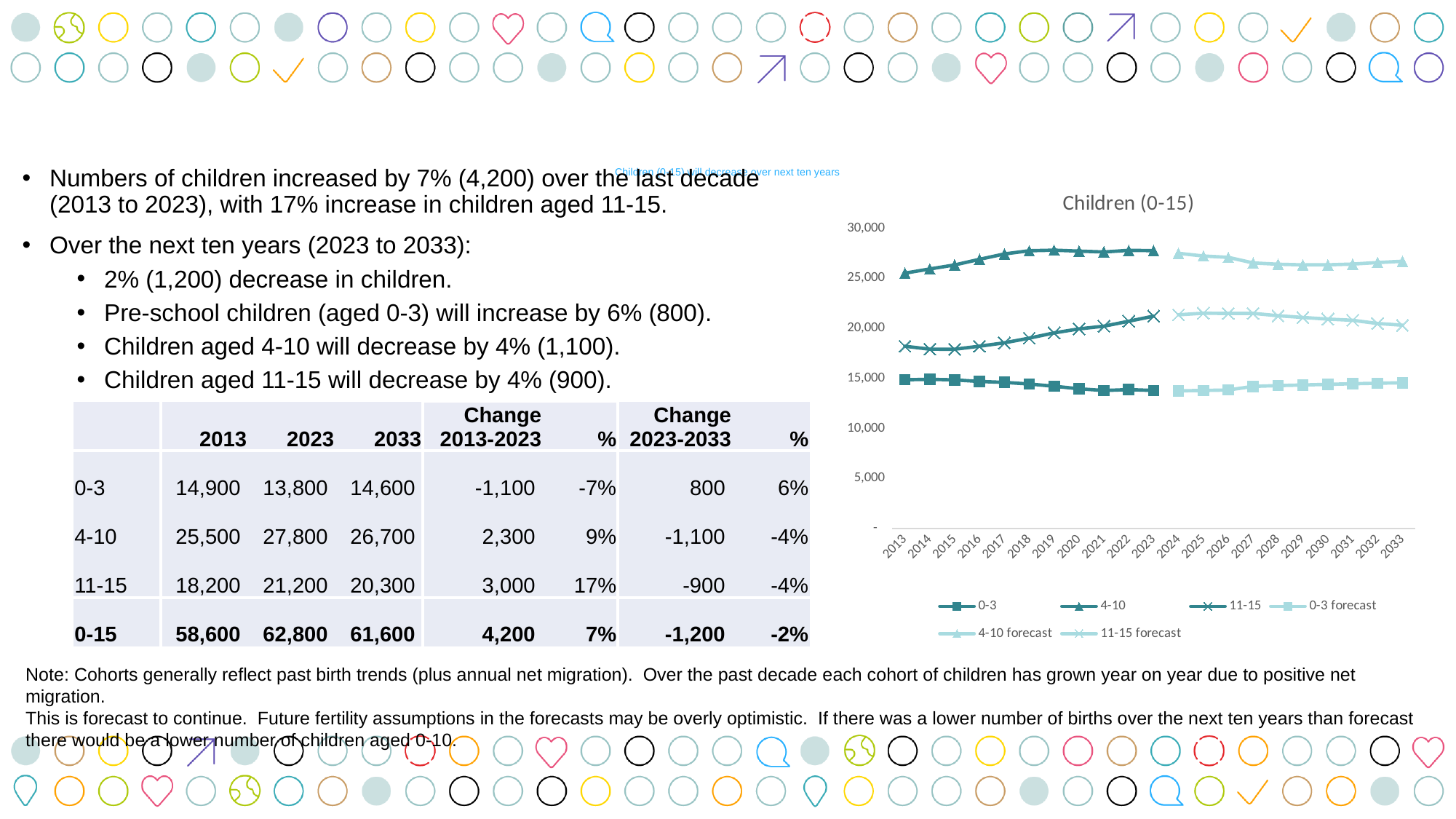
Which series has the highest values in 2023? 4-10 What is the title of the chart? Children (0-15) Does the 0-3 series rise or fall from 2013 to 2023? fall How many series does the chart legend list? 6 Is the value for 4-10 in 2019 greater or less than 25,000? greater Does the 11-15 series rise or fall from 2013 to 2023? rise Is the value for 0-3 in 2023 greater or less than 15,000? less How many years are shown along the x axis of the chart? 21 Which series has the lowest values in 2013? 0-3 In 2013, which is larger: the value for 11-15 or the value for 0-3? 11-15 What kind of chart is shown on the slide? line chart Is the value for 11-15 in 2013 greater or less than 20,000? less